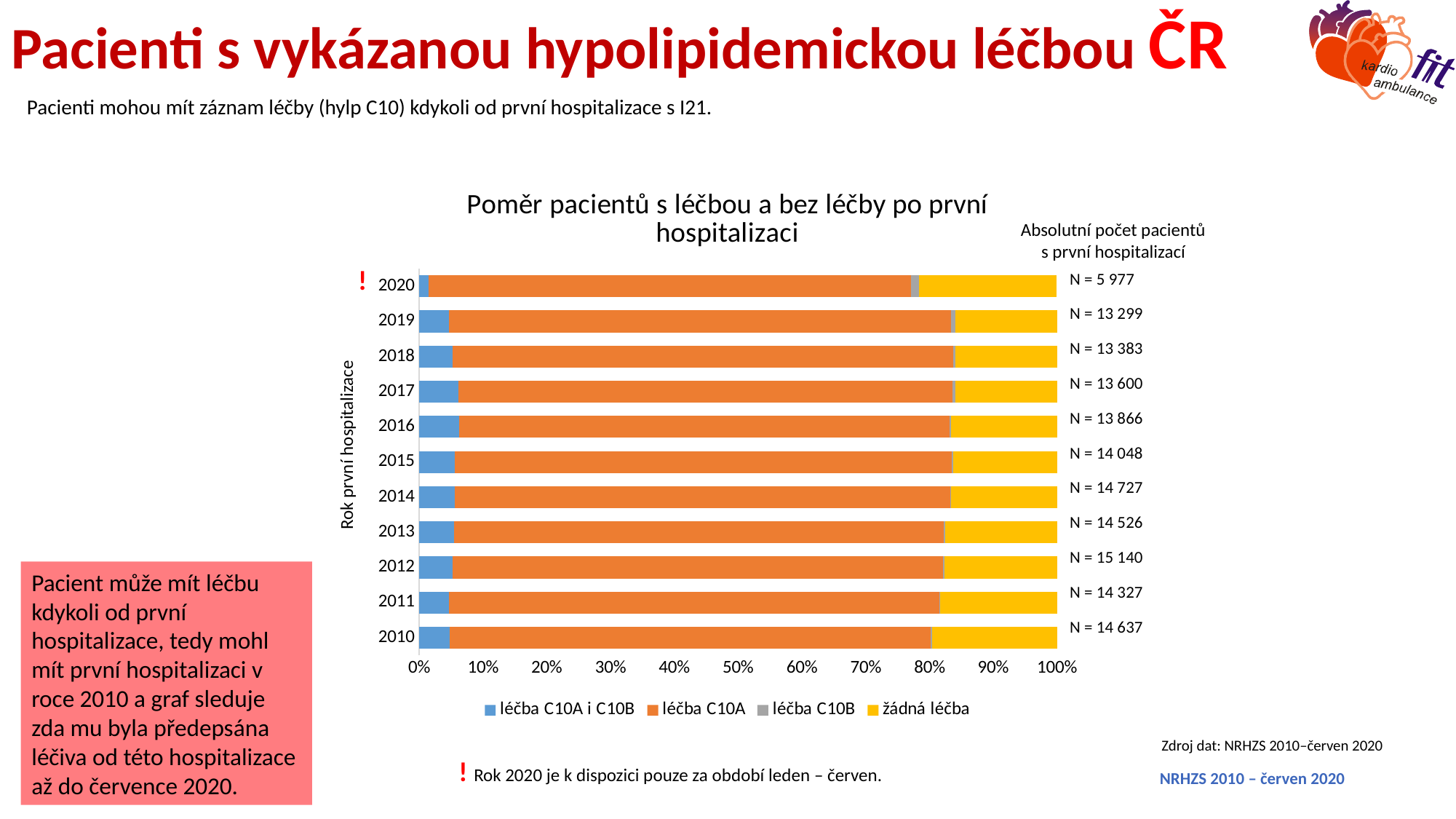
Which legend entry is shown in yellow? žádná léčba Which year has the highest absolute number of patients with a first hospitalisation (N)? 2012 Is the share of 'léčba C10A i C10B' for 2020 greater or less than 10%? less How many series does the chart legend list? 4 Which year has the lowest absolute number of patients with a first hospitalisation (N)? 2020 How many years (categories) are plotted on the y axis of the chart? 11 What is the absolute number of patients (N) shown for the year 2020? N = 5 977 What is the absolute number of patients (N) shown for the year 2012? N = 15 140 What is the difference between the N value for 2012 and the N value for 2020? 9 163 What kind of chart is shown on the slide? bar chart Which year has a larger N value, 2018 or 2019? 2018 What is the absolute number of patients (N) shown for the year 2010? N = 14 637